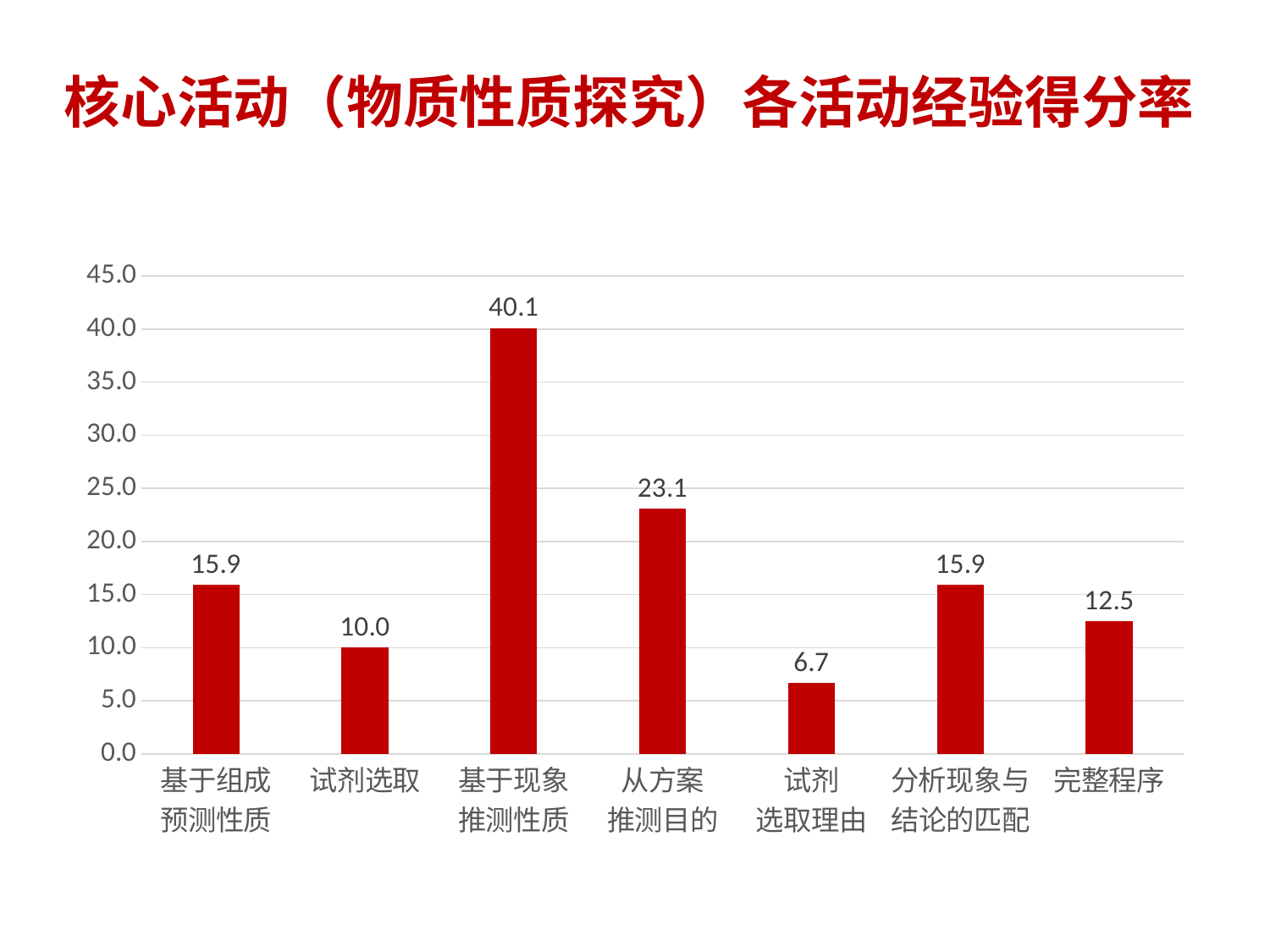
What is the value for 试剂选取理由? 6.7 Which category has the highest value? 基于现象推测性质 Is the value for 从方案推测目的 greater or less than 20.0? greater What is the value for 基于现象推测性质? 40.1 Which is larger, the value for 从方案推测目的 or the value for 完整程序? 从方案推测目的 What is the title of the slide? 核心活动（物质性质探究）各活动经验得分率 What is the difference between the values for 基于现象推测性质 and 从方案推测目的? 17.0 What is the difference between the values for 试剂选取 and 试剂选取理由? 3.3 What is the value for 完整程序? 12.5 How many categories are shown on the x axis? 7 What kind of chart is shown on the slide? bar chart Which category has the lowest value? 试剂选取理由